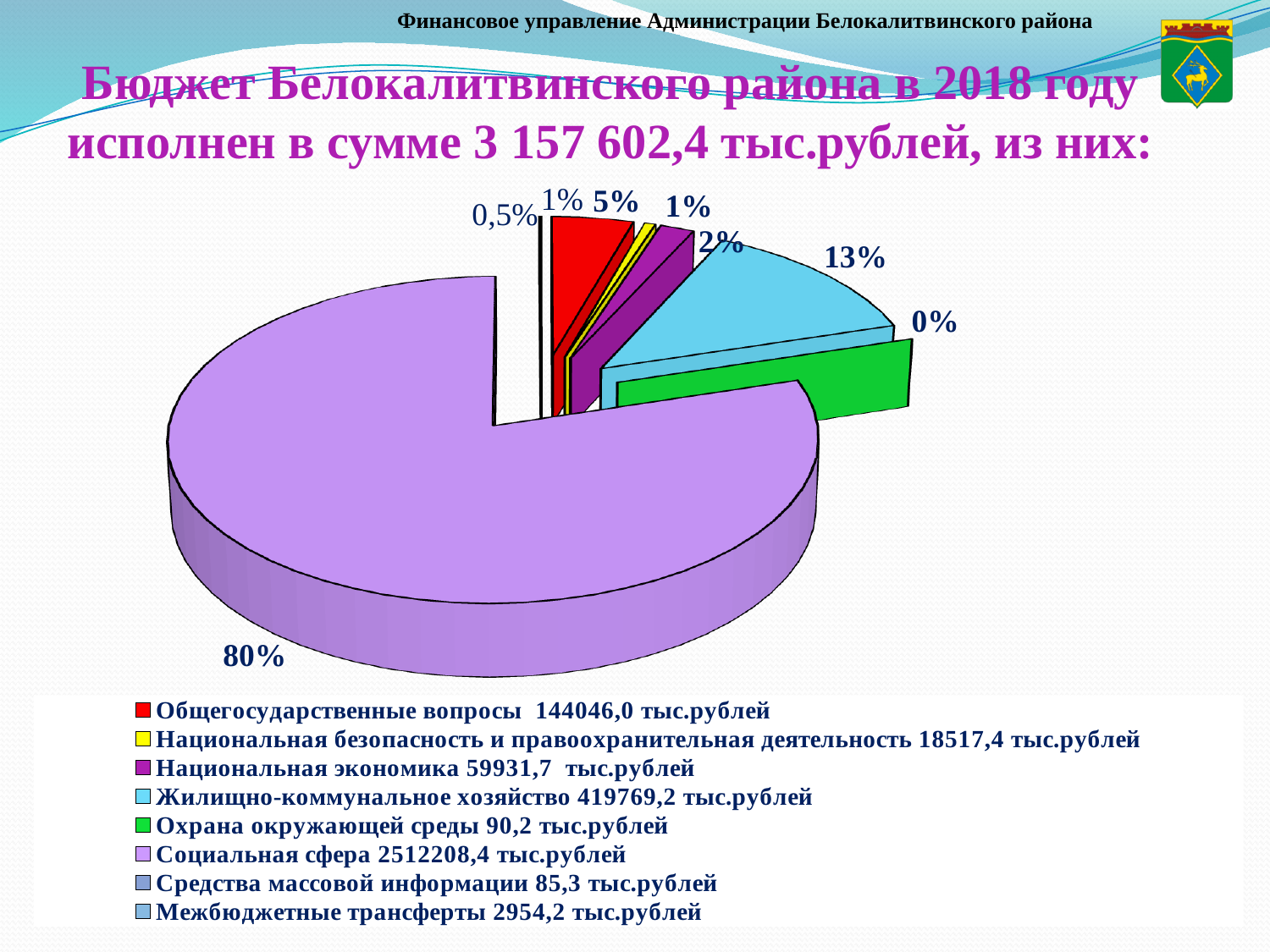
What share of the pie does Социальная сфера take? 80% How many categories does the legend of the pie chart list? 8 What share of the pie does Национальная экономика take? 2% What amount is shown in the legend for Охрана окружающей среды? 90,2 тыс.рублей Which is larger: the amount for Общегосударственные вопросы or for Национальная экономика? Общегосударственные вопросы What share of the pie does Жилищно-коммунальное хозяйство take? 13% What is the difference between the amounts for Общегосударственные вопросы and Национальная экономика? 84114,3 тыс.рублей Which category has the largest share of the pie? Социальная сфера What amount is shown in the legend for Жилищно-коммунальное хозяйство? 419769,2 тыс.рублей What kind of chart is shown on the slide? pie chart Which category has the smallest amount according to the legend? Средства массовой информации